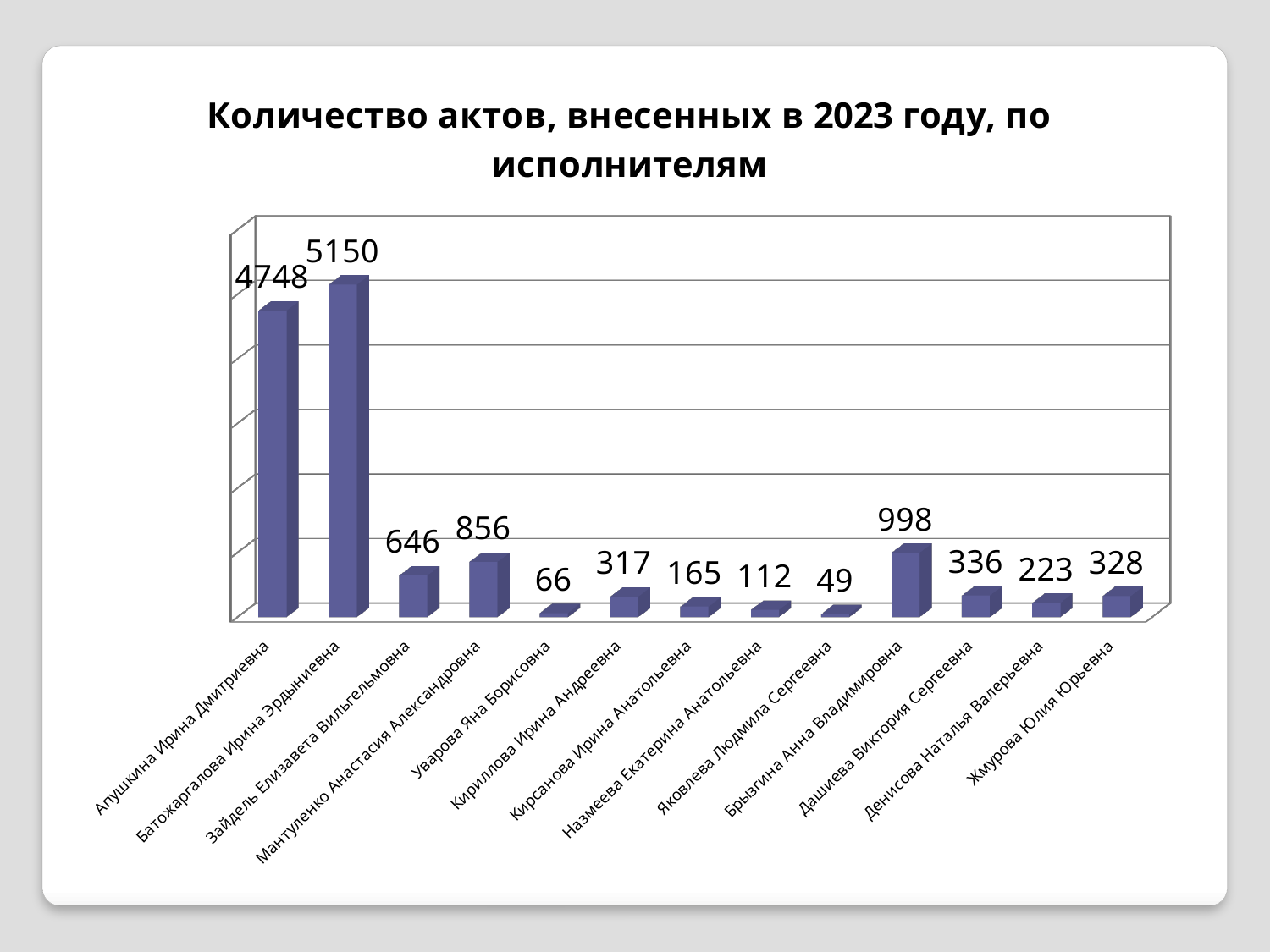
What is the difference between the values for Мантуленко Анастасия Александровна and Зайдель Елизавета Вильгельмовна? 210 Which executor has the lowest number of acts? Яковлева Людмила Сергеевна What is the value for Брызгина Анна Владимировна? 998 Which executor has the highest number of acts? Батожаргалова Ирина Эрдыниевна What type of chart is shown on the slide? Bar chart How many acts did Апушкина Ирина Дмитриевна enter in 2023? 4748 How many executors (categories) are shown in the chart? 13 Who has more acts, Дашиева Виктория Сергеевна or Жмурова Юлия Юрьевна? Дашиева Виктория Сергеевна What is the value for Уварова Яна Борисовна? 66 What is the title of the chart? Количество актов, внесенных в 2023 году, по исполнителям Who has more acts, Кириллова Ирина Андреевна or Кирсанова Ирина Анатольевна? Кириллова Ирина Андреевна What is the difference between the values for Батожаргалова Ирина Эрдыниевна and Апушкина Ирина Дмитриевна? 402